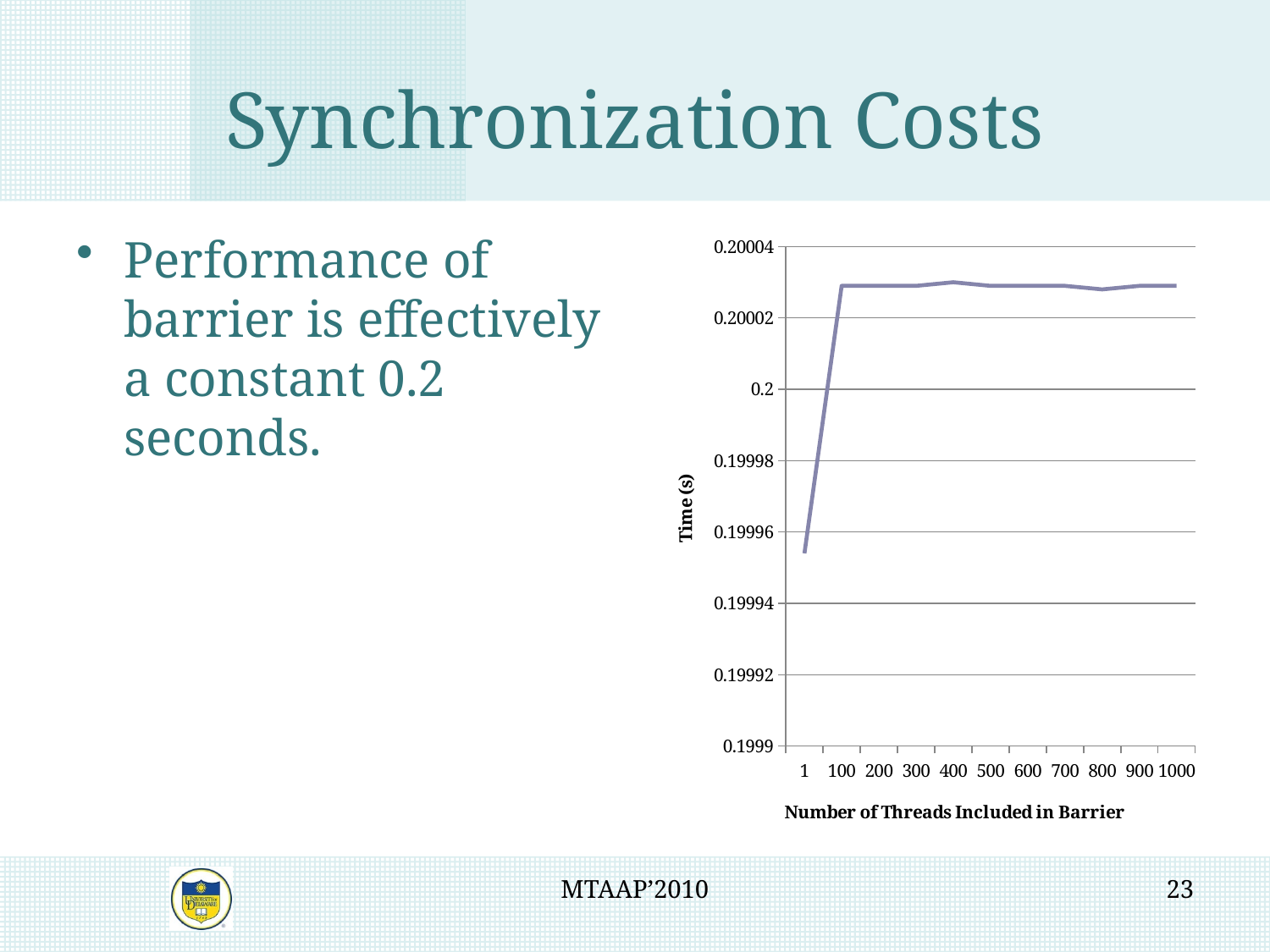
What is the label of the y axis of the chart? Time (s) What is the label of the x axis of the chart? Number of Threads Included in Barrier Is the time for 800 threads greater or less than 0.2? greater Is the time for 1 thread greater or less than 0.19996? less Which has the larger time: 1 thread or 500 threads? 500 threads How many data points are plotted along the x axis of the chart? 11 Is the time for 1000 threads greater or less than 0.2? greater Does the time rise or fall between 1 thread and 100 threads? rise At which number of threads is the time lowest? 1 What kind of chart is shown on the slide? line chart